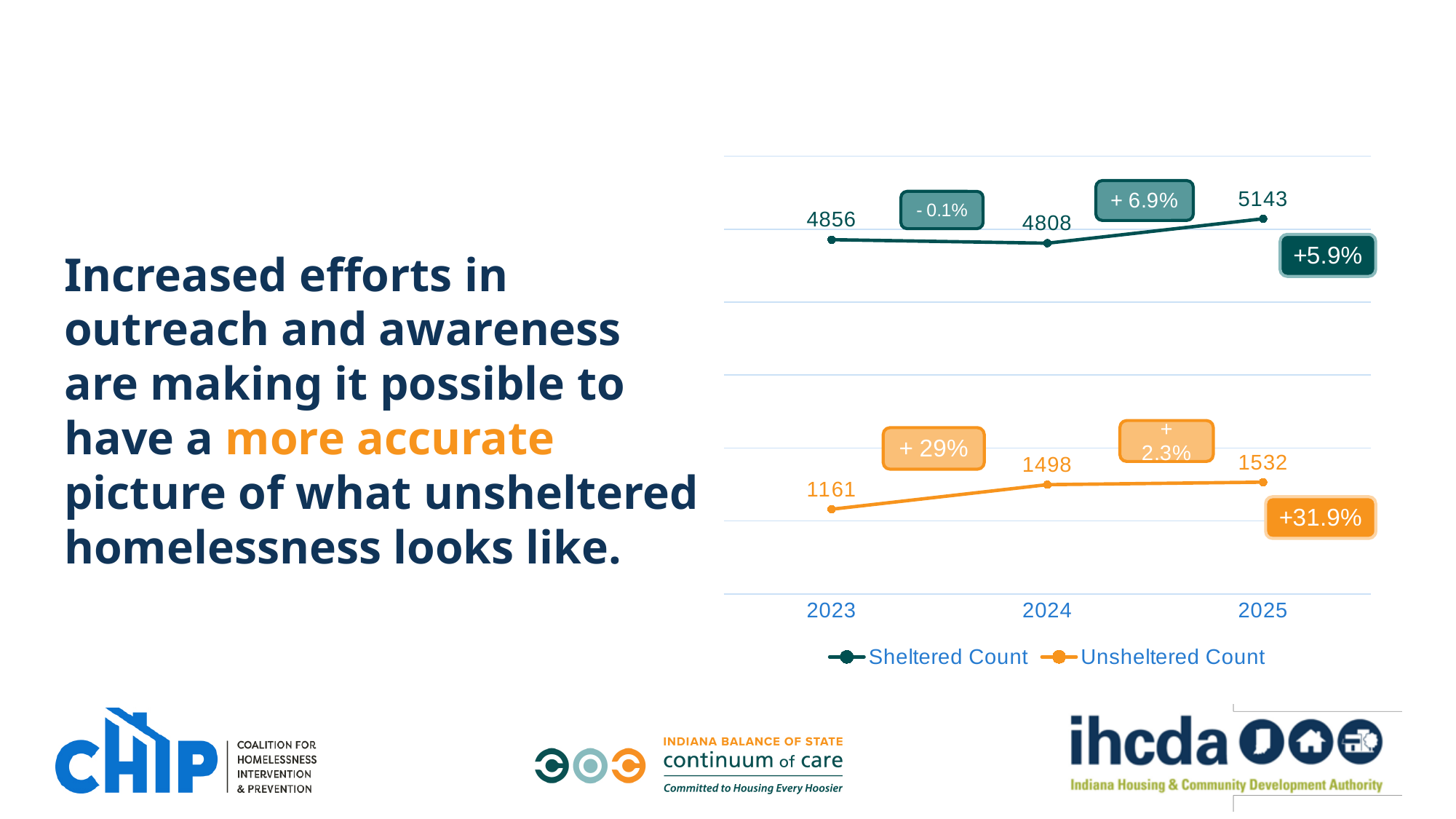
In which year is the Sheltered Count lowest? 2024 What is the Sheltered Count for 2023? 4856 What is the Unsheltered Count for 2024? 1498 In which year is the Unsheltered Count highest? 2025 What is the Sheltered Count for 2025? 5143 Which is larger in 2025, the Sheltered Count or the Unsheltered Count? Sheltered Count What is the difference between the Sheltered Count in 2025 and in 2024? 335 What is the difference between the Unsheltered Count in 2024 and in 2023? 337 What kind of chart is shown on the slide? Line chart Does the Unsheltered Count rise or fall from 2023 to 2025? Rise How many series does the legend list? 2 What is the Unsheltered Count for 2023? 1161